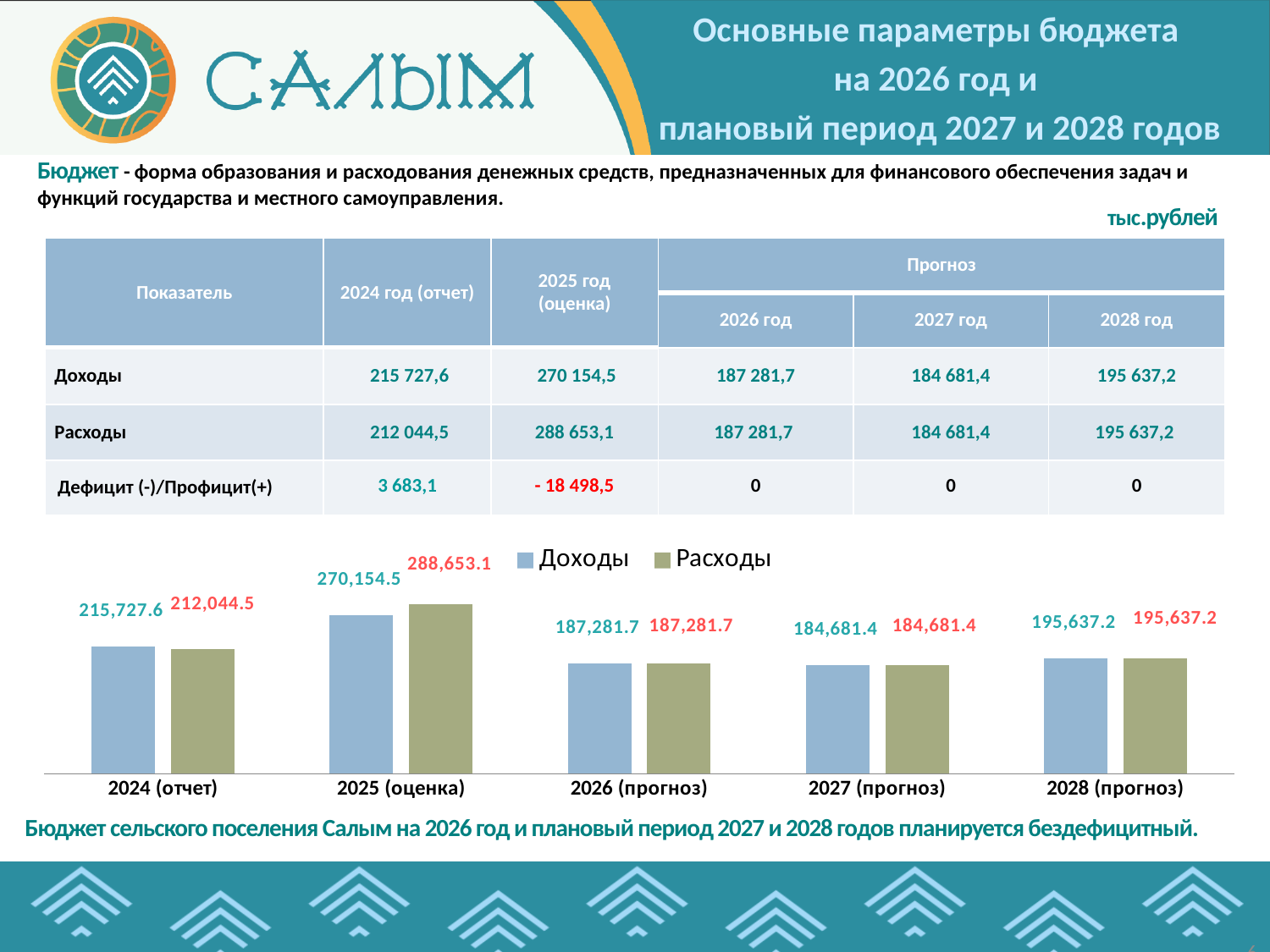
Which category has the lowest Доходы value in the bar chart? 2027 (прогноз) In the bar chart, which is larger for 2024 (отчет): Доходы or Расходы? Доходы What kind of chart is shown on the slide? bar chart Which series in the bar chart is shown in green? Расходы Do the Доходы values rise or fall from 2025 (оценка) to 2026 (прогноз) in the bar chart? fall What is the value of Доходы for 2028 (прогноз) in the bar chart? 195,637.2 Which category has the highest Расходы value in the bar chart? 2025 (оценка) What is the value of Расходы for 2025 (оценка) in the bar chart? 288,653.1 How many series does the legend of the bar chart list? 2 How many categories are shown on the x axis of the bar chart? 5 What is the value of Доходы for 2024 (отчет) in the bar chart? 215,727.6 What is the difference between Расходы and Доходы for 2025 (оценка) in the bar chart? 18,498.6